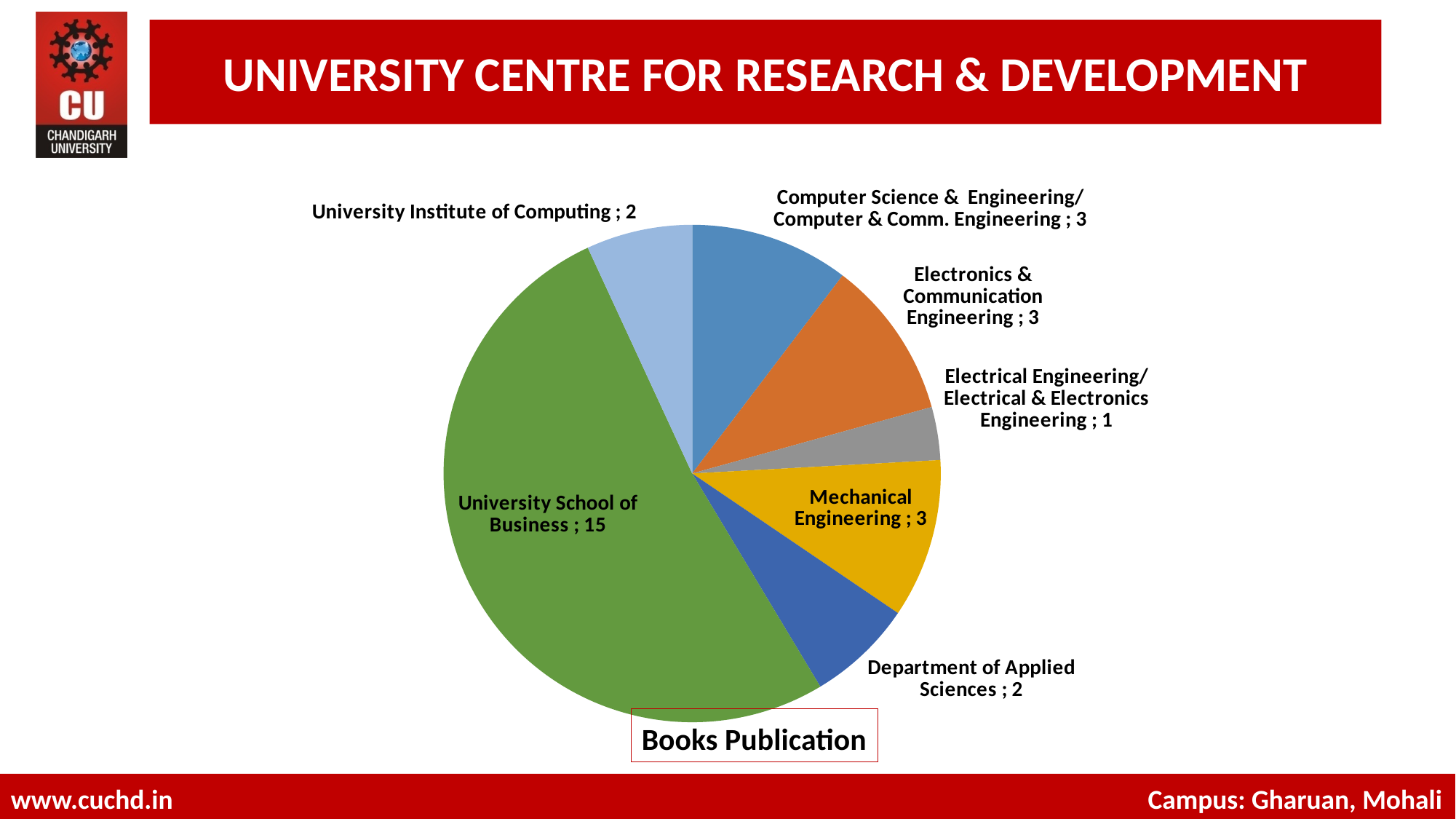
What is the value for Electrical Engineering/ Electrical & Electronics Engineering? 1 What is the value for Mechanical Engineering? 3 Which category has the smallest slice of the pie? Electrical Engineering/ Electrical & Electronics Engineering How many categories (slices) does the pie chart have? 7 What kind of chart is shown on the slide? Pie chart Which category has the largest slice of the pie? University School of Business What is the title shown below the pie chart? Books Publication What is the value for University School of Business? 15 What is the total of all the values in the pie chart? 29 What is the difference between the value for University School of Business and the value for Electronics & Communication Engineering? 12 What is the value for Department of Applied Sciences? 2 Which is larger, the value for University Institute of Computing or the value for Computer Science & Engineering/ Computer & Comm. Engineering? Computer Science & Engineering/ Computer & Comm. Engineering